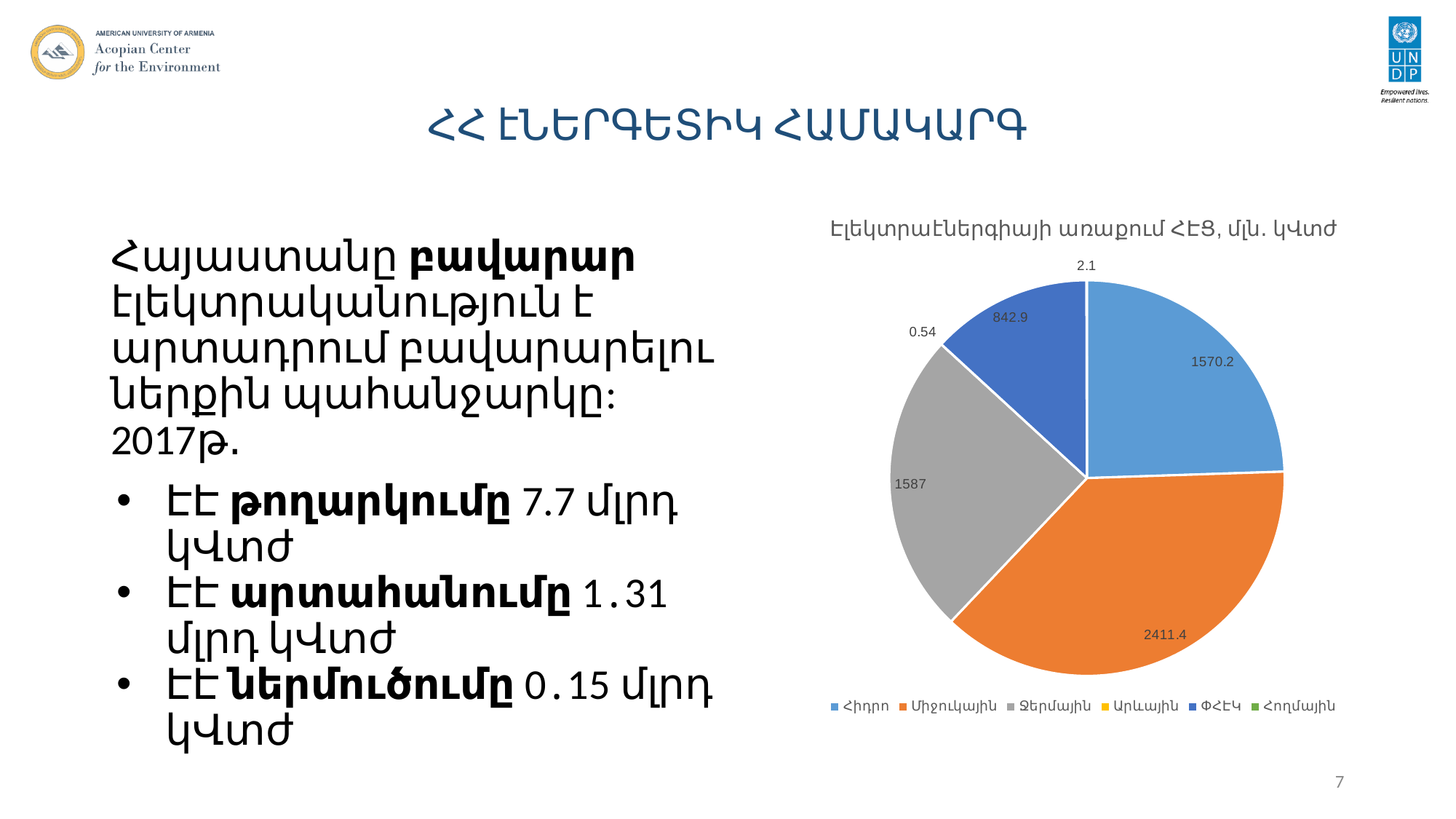
What is the value for Հիդրո in the pie chart? 1570.2 What colour is the Միջուկային slice in the pie chart? orange How many categories does the pie chart legend list? 6 Which is larger, the value for Միջուկային or the value for Հիդրո? Միջուկային What is the value for Միջուկային in the pie chart? 2411.4 What is the title of the pie chart? Էլեկտրաէներգիայի առաքում ՀԷՑ, մլն. կՎտժ Which category has the largest slice in the pie chart? Միջուկային What kind of chart is shown on the slide? pie chart What is the difference between the values for Միջուկային and Ջերմային? 824.4 What is the value for Ջերմային in the pie chart? 1587 Which category has the smallest value in the pie chart? Արևային What is the value for ՓՀԷԿ in the pie chart? 842.9